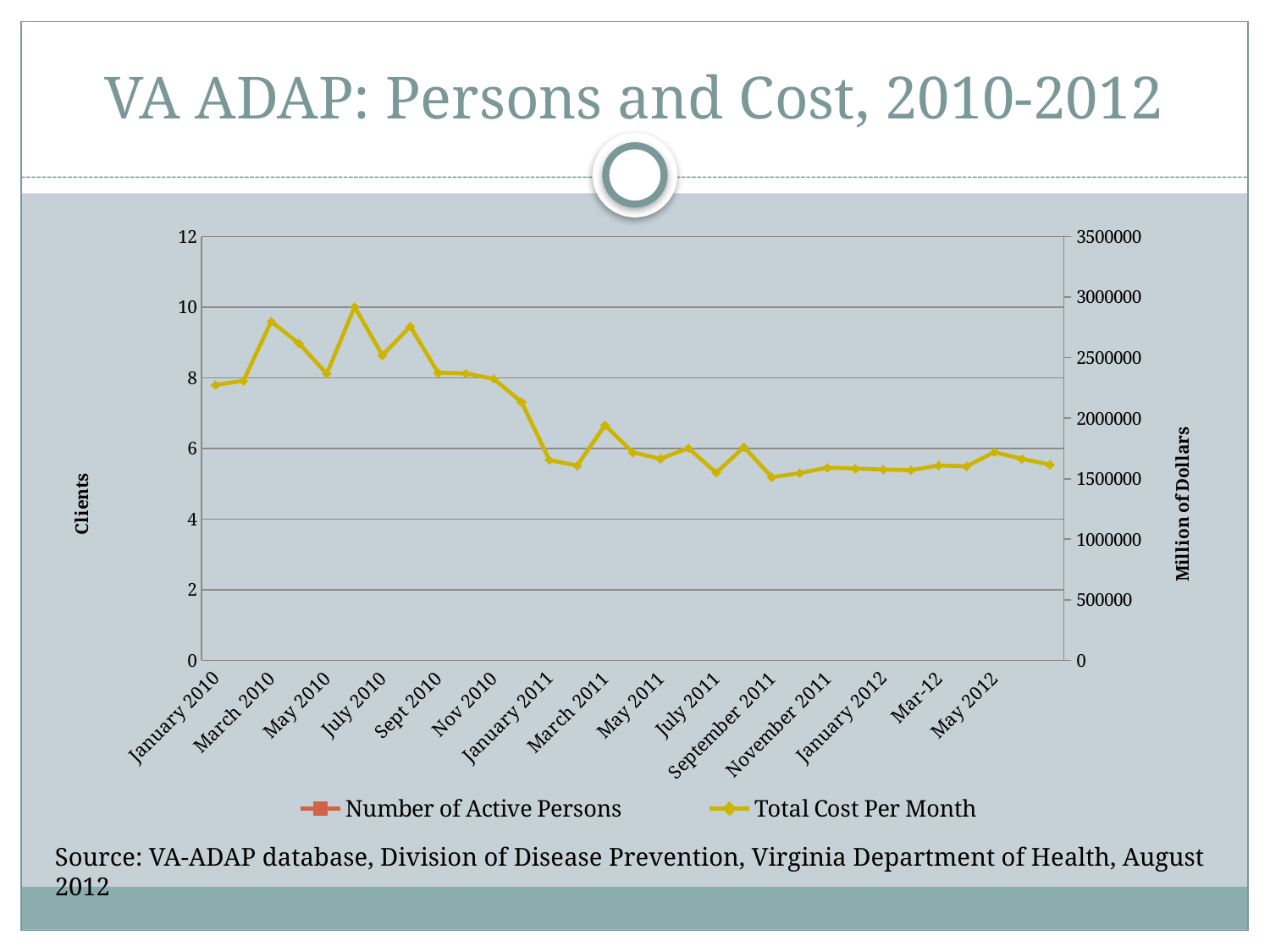
What is the label of the right-hand vertical axis? Million of Dollars Which has the larger Total Cost Per Month, March 2010 or May 2010? March 2010 How many series does the legend list? 2 Is the Total Cost Per Month value for January 2010 greater or less than 2000000? greater Is the Total Cost Per Month value for January 2011 greater or less than 2000000? less What kind of chart is shown on the slide? line chart What is the title of the chart? VA ADAP: Persons and Cost, 2010-2012 Is the Total Cost Per Month value for May 2012 greater or less than 2000000? less Overall, does the Total Cost Per Month line rise or fall from January 2010 to May 2012? fall